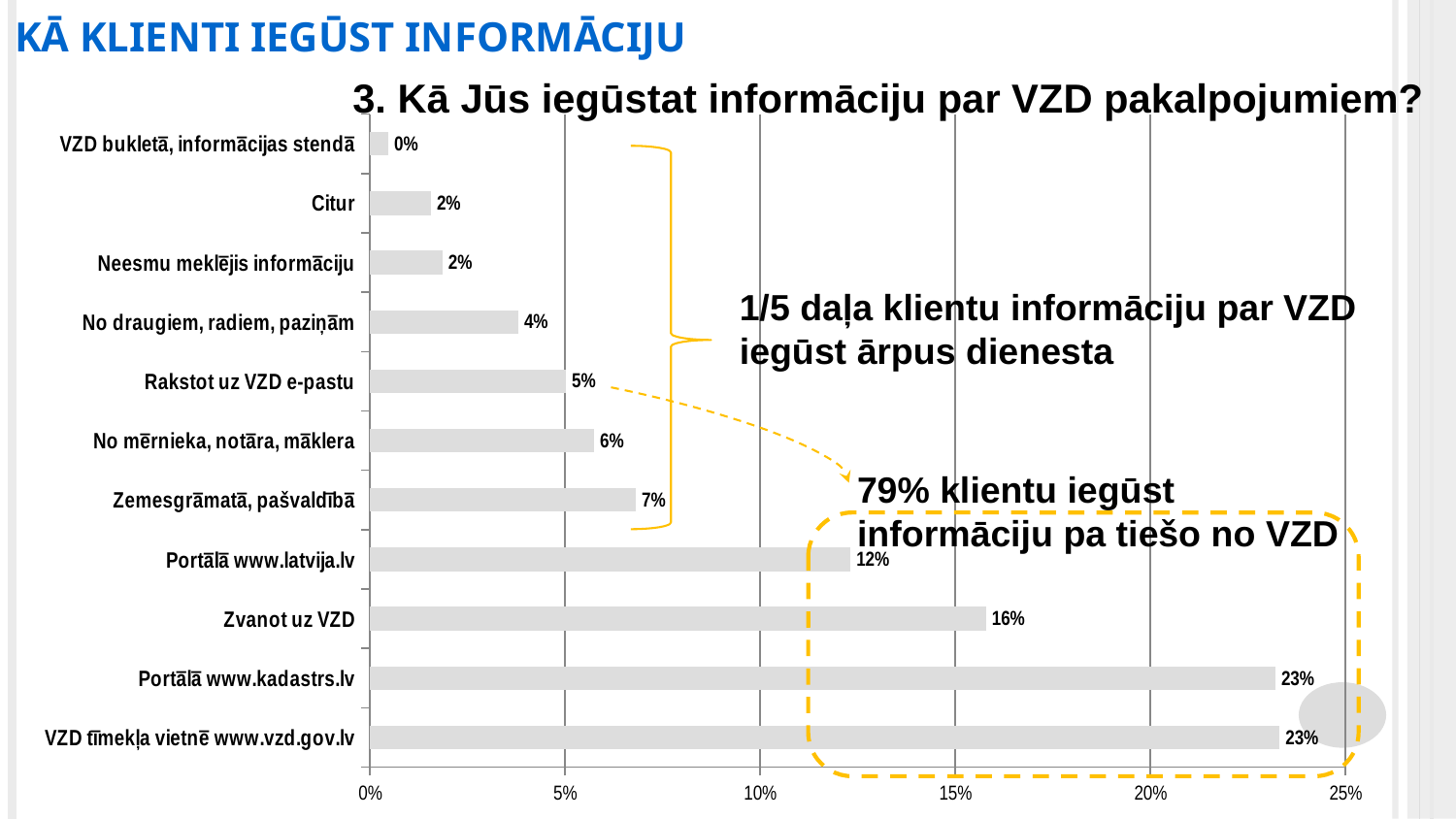
Which is larger, the value for "Rakstot uz VZD e-pastu" or the value for "No mērnieka, notāra, māklera"? No mērnieka, notāra, māklera Which category has the lowest value? VZD bukletā, informācijas stendā What is the difference between the values for "Portālā www.kadastrs.lv" and "Zvanot uz VZD"? 7% What is the value for "Portālā www.latvija.lv"? 12% What is the value for "Portālā www.kadastrs.lv"? 23% How many categories are shown in the chart? 11 What is the value for "Zemesgrāmatā, pašvaldībā"? 7% What is the value for "No draugiem, radiem, paziņām"? 4% What is the title of the chart? 3. Kā Jūs iegūstat informāciju par VZD pakalpojumiem? What kind of chart is shown on the slide? Bar chart What is the highest value shown on the x axis? 25% What is the value for "Zvanot uz VZD"? 16%